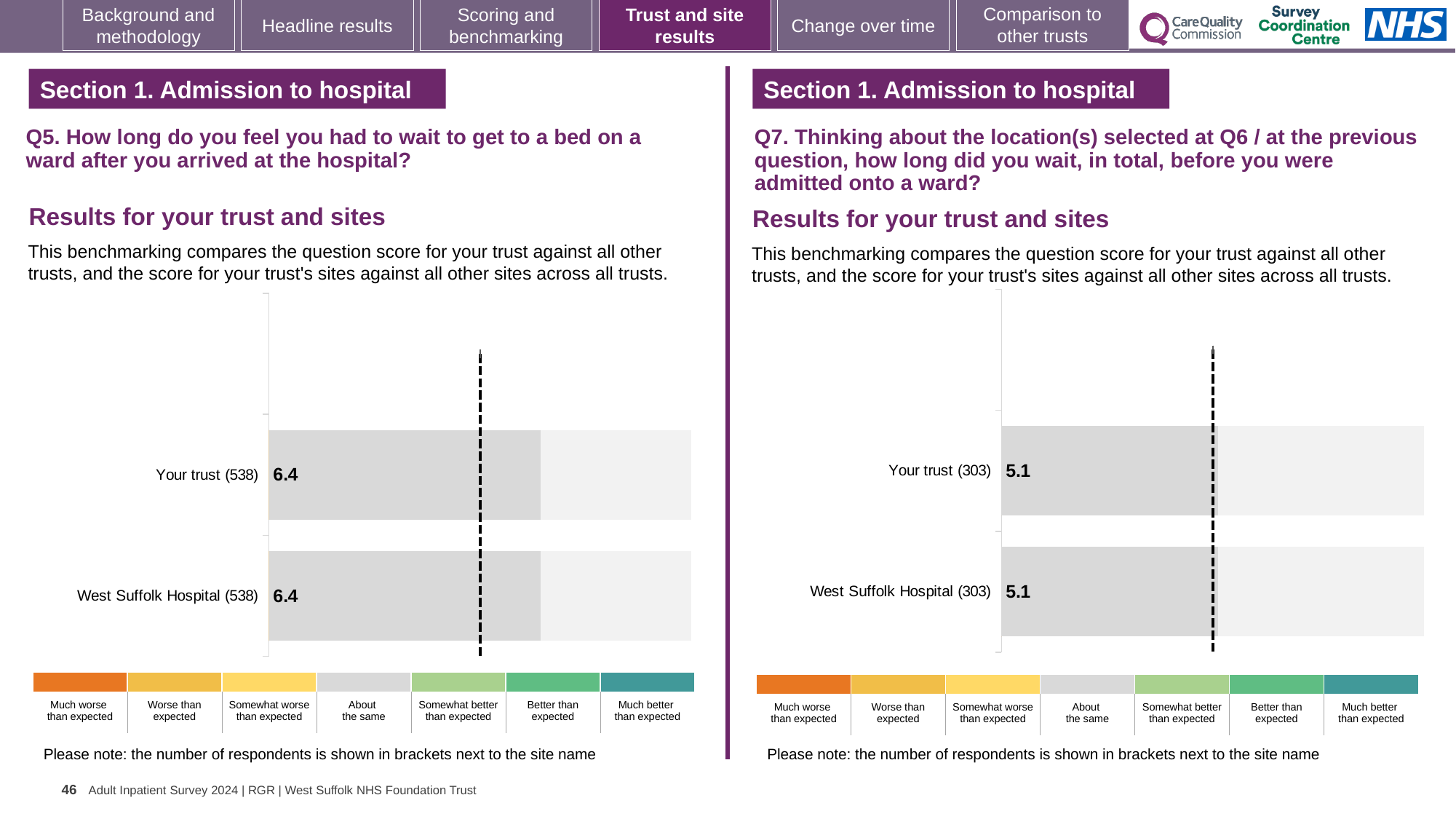
How many bars are plotted on the right chart (Q7)? 2 On the left chart (Q5), how many respondents are shown in brackets next to Your trust? 538 What kind of chart is used on the left (Q5)? Bar chart On the left chart (Q5), what is the score for Your trust? 6.4 On the right chart (Q7), what is the difference between the score for Your trust and the score for West Suffolk Hospital? 0 On the right chart (Q7), what is the score for Your trust? 5.1 On the right chart (Q7), what is the score for West Suffolk Hospital? 5.1 How many bars are plotted on the left chart (Q5)? 2 On the left chart (Q5), what is the difference between the score for Your trust and the score for West Suffolk Hospital? 0 On the left chart (Q5), what is the score for West Suffolk Hospital? 6.4 On the right chart (Q7), how many respondents are shown in brackets next to West Suffolk Hospital? 303 Is the score for Your trust on the left chart (Q5) larger or smaller than the score for Your trust on the right chart (Q7)? Larger